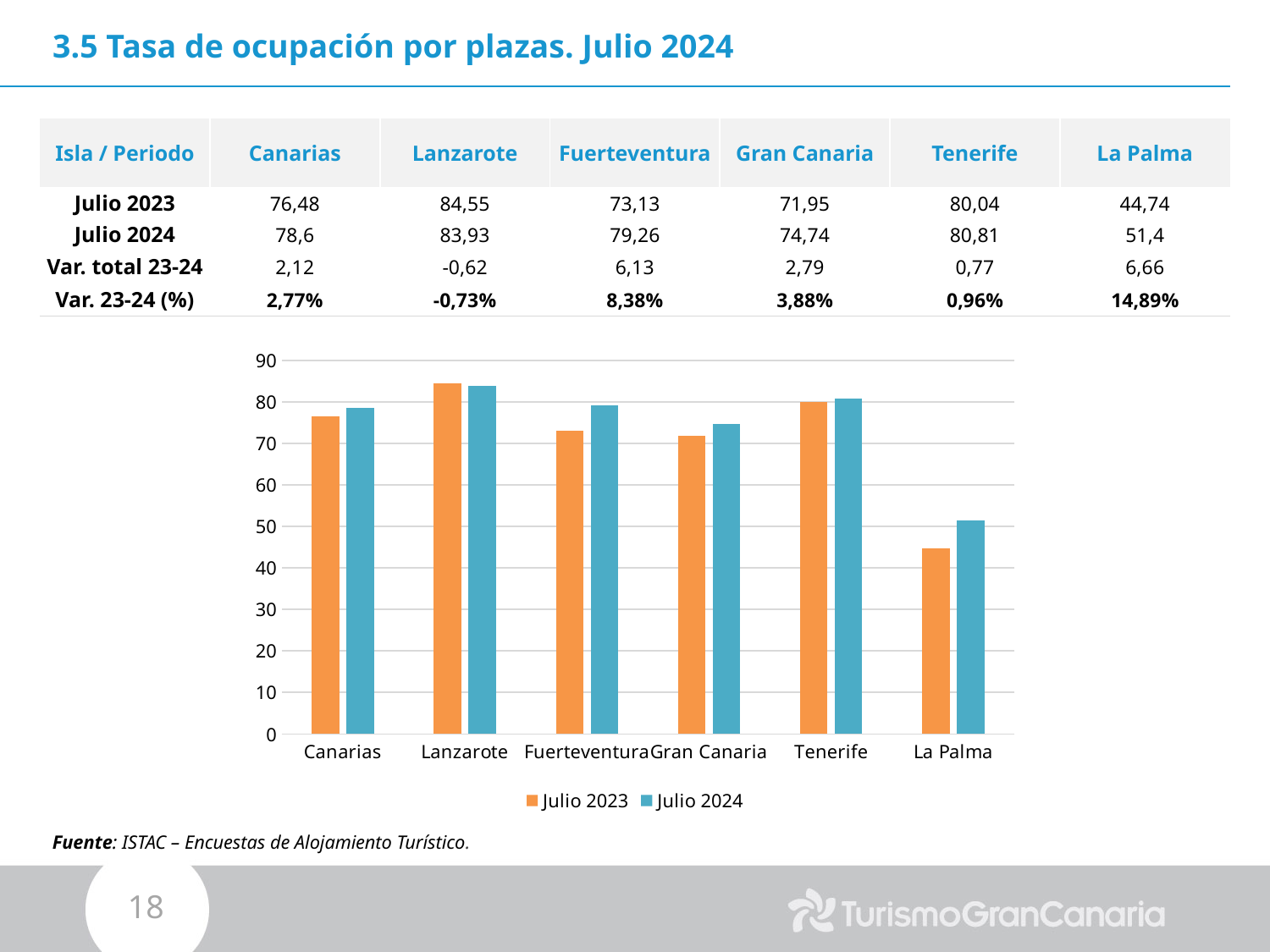
According to the table, what is the Julio 2023 occupancy rate for Lanzarote? 84,55 What is the difference between the Julio 2024 and Julio 2023 values for Fuerteventura, as shown in the table? 6,13 Which category has the lowest value for Julio 2024? La Palma According to the table, what is the Julio 2024 occupancy rate for Gran Canaria? 74,74 For Fuerteventura, which is larger: the Julio 2023 bar or the Julio 2024 bar? Julio 2024 Is the Julio 2024 value for La Palma greater or less than 60? less What kind of chart is shown on the slide? bar chart How many islands/categories are shown on the x axis of the chart? 6 What colour are the Julio 2024 bars in the chart? blue How many series does the chart legend list? 2 Is the Julio 2023 value for Tenerife greater or less than 70? greater Which category has the highest value for Julio 2023? Lanzarote